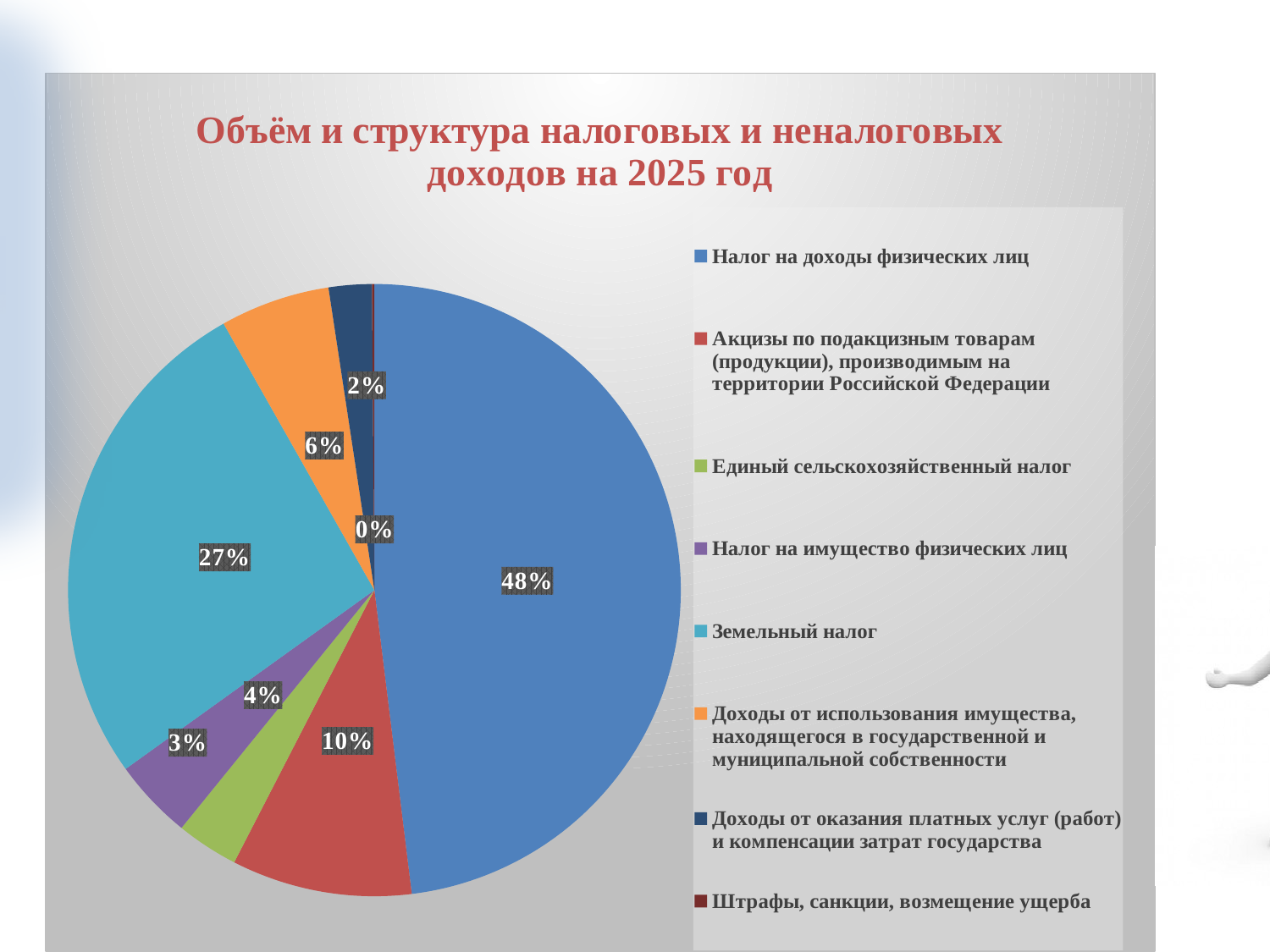
Which category has the smallest share of the pie? Штрафы, санкции, возмещение ущерба What is the value shown for "Доходы от оказания платных услуг (работ) и компенсации затрат государства"? 2% How many categories does the legend of the pie chart list? 8 What share of the pie does "Земельный налог" have? 27% By how many percentage points does "Налог на доходы физических лиц" exceed "Земельный налог"? 21 What is the value shown for "Акцизы по подакцизным товарам (продукции), производимым на территории Российской Федерации"? 10% What share of the pie does "Налог на доходы физических лиц" have? 48% What is the value shown for "Доходы от использования имущества, находящегося в государственной и муниципальной собственности"? 6% What is the value shown for "Штрафы, санкции, возмещение ущерба"? 0% Which category has the largest share of the pie? Налог на доходы физических лиц What kind of chart is shown on the slide? pie chart What is the title of the chart? Объём и структура налоговых и неналоговых доходов на 2025 год